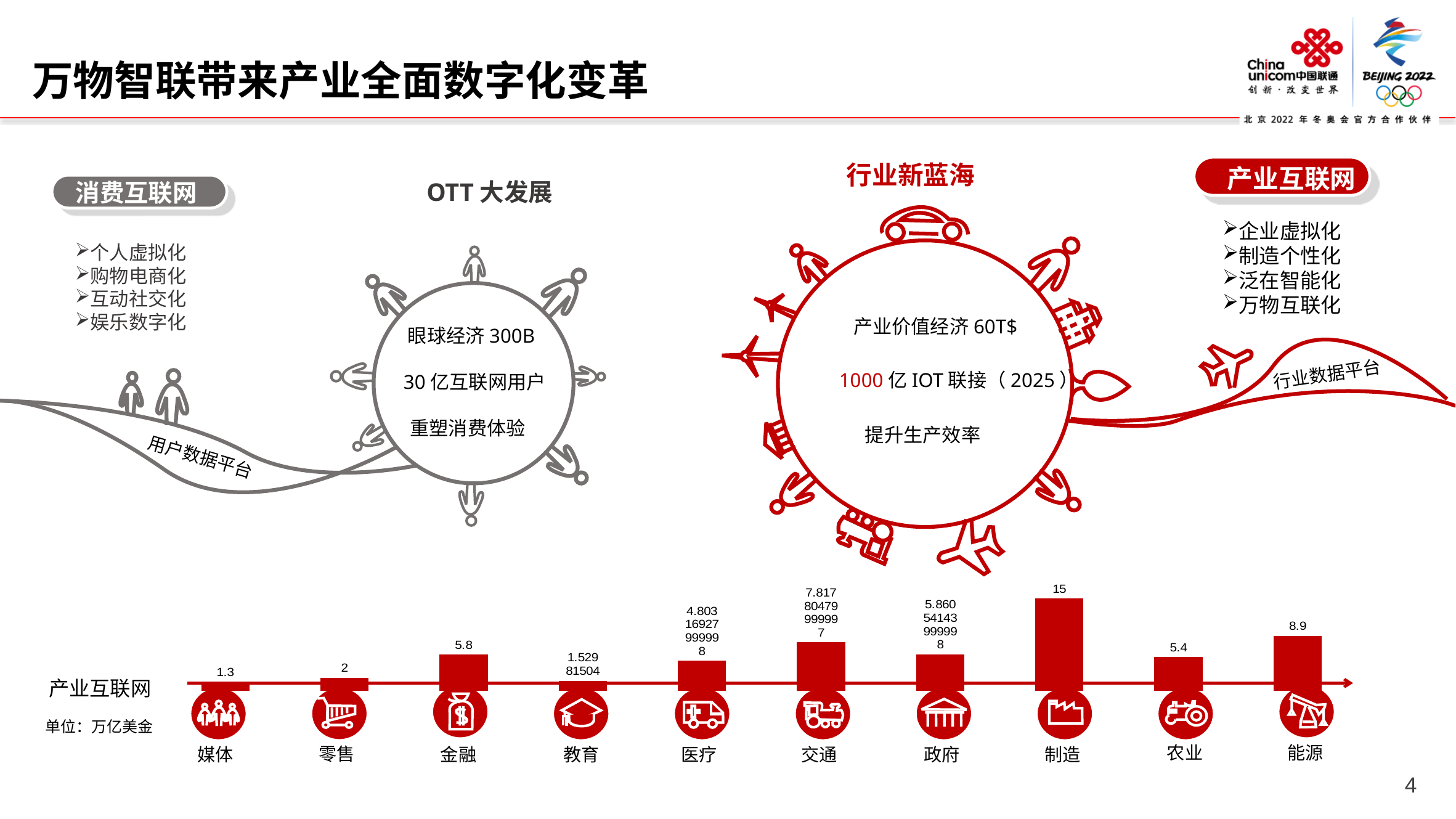
In the 产业互联网 bar chart, which category has the lowest value? 媒体 In the 产业互联网 bar chart, what is the value for 媒体? 1.3 What kind of chart is shown at the bottom of the slide under 产业互联网? bar chart In the 产业互联网 bar chart, what is the value for 农业? 5.4 In the 产业互联网 bar chart, which is larger, the value for 金融 or the value for 农业? 金融 What unit is stated for the values in the 产业互联网 bar chart? 万亿美金 In the 产业互联网 bar chart, what is the value for 零售? 2 In the 产业互联网 bar chart, what is the value for 能源? 8.9 In the 产业互联网 bar chart, what is the difference between the values for 能源 and 金融? 3.1 In the 产业互联网 bar chart, what is the value for 制造? 15 How many categories are shown in the 产业互联网 bar chart? 10 In the 产业互联网 bar chart, which category has the highest value? 制造